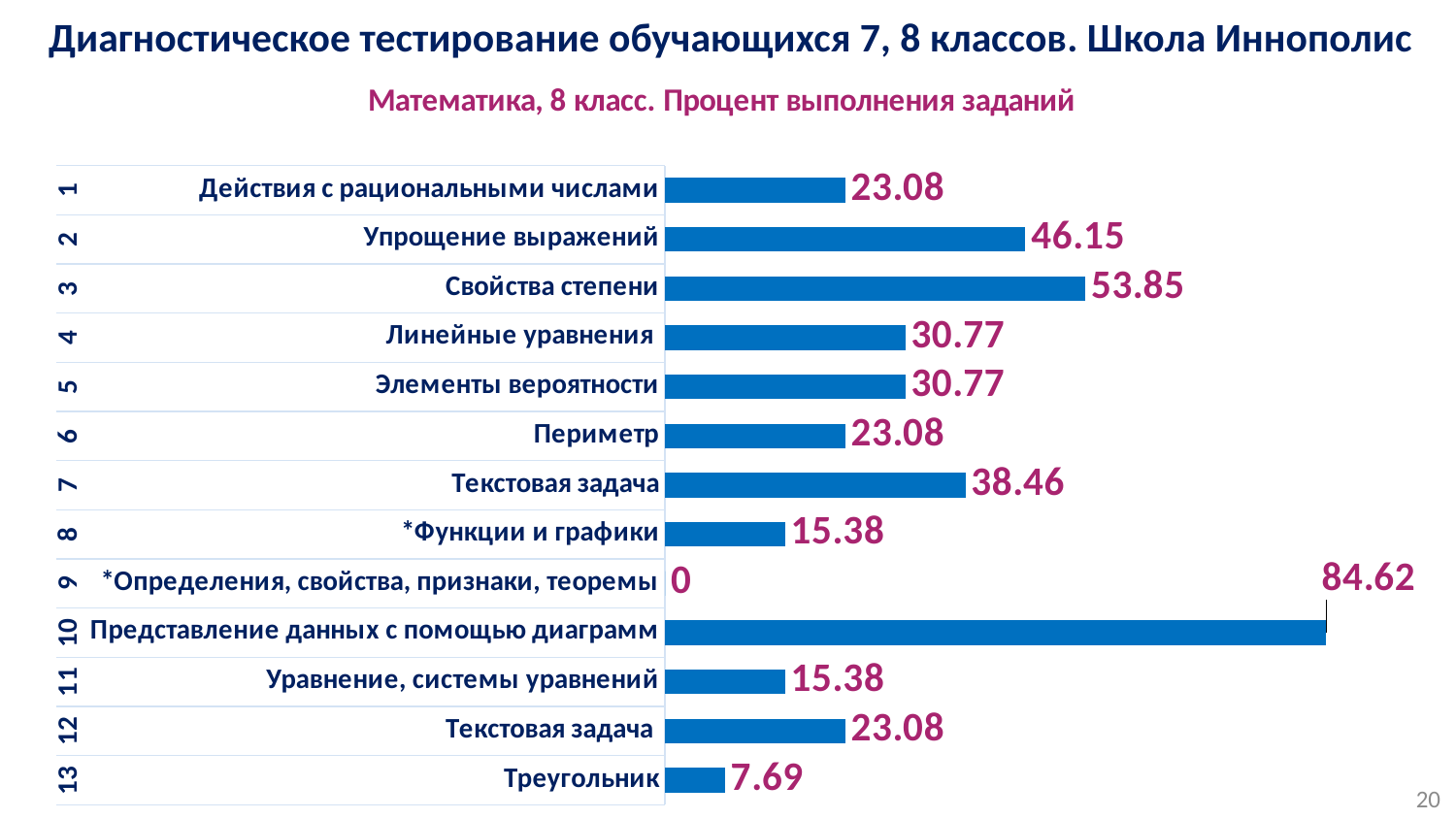
What is the value for «Свойства степени»? 53.85 Which category has the highest value? Представление данных с помощью диаграмм What is the value for «Упрощение выражений»? 46.15 What is the value for task 9, «*Определения, свойства, признаки, теоремы»? 0 Which category has the lowest value? *Определения, свойства, признаки, теоремы How many categories (tasks) are shown in the chart? 13 What is the difference between the values for «Представление данных с помощью диаграмм» and «Свойства степени»? 30.77 What is the difference between the values for «Упрощение выражений» and «Действия с рациональными числами»? 23.07 What is the subtitle of the chart? Математика, 8 класс. Процент выполнения заданий Which is larger: the value for task 7 «Текстовая задача» or the value for «Линейные уравнения»? Текстовая задача (task 7) What kind of chart is shown on the slide? Bar chart What is the value for «Треугольник»? 7.69